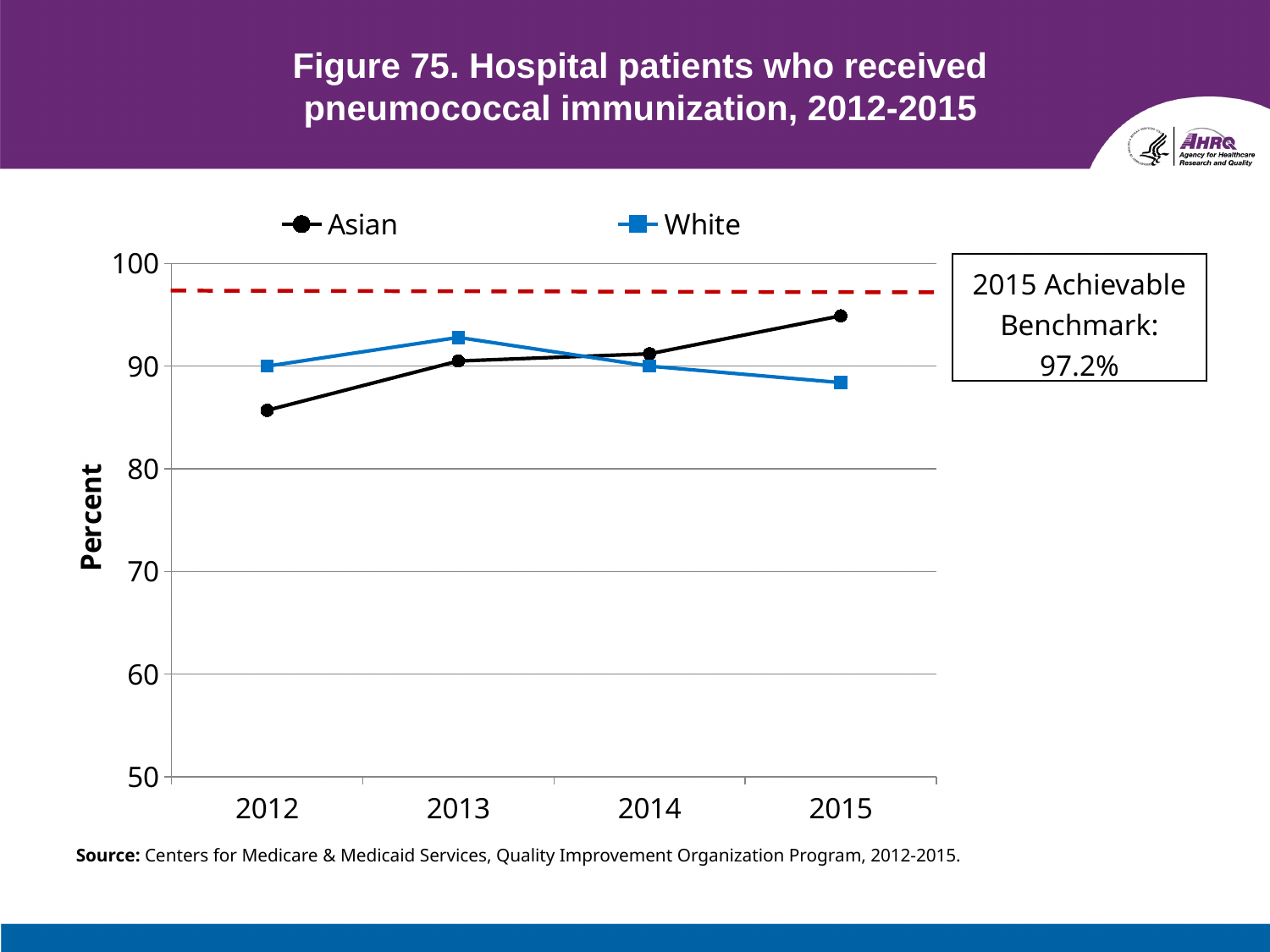
Is the value for Asian in 2015 greater or less than 90? greater What is the label on the y axis? Percent In 2015, which series has the higher value, Asian or White? Asian How many years are plotted along the x axis? 4 What is the 2015 Achievable Benchmark shown on the slide? 97.2% Is the value for White in 2013 greater or less than 90? greater How many series does the legend list? 2 Is the value for Asian in 2012 greater or less than 90? less In which year is the Asian series at its highest? 2015 In 2012, which series has the higher value, Asian or White? White What kind of chart is shown on the slide? line chart Does the Asian series rise or fall from 2012 to 2015? rise